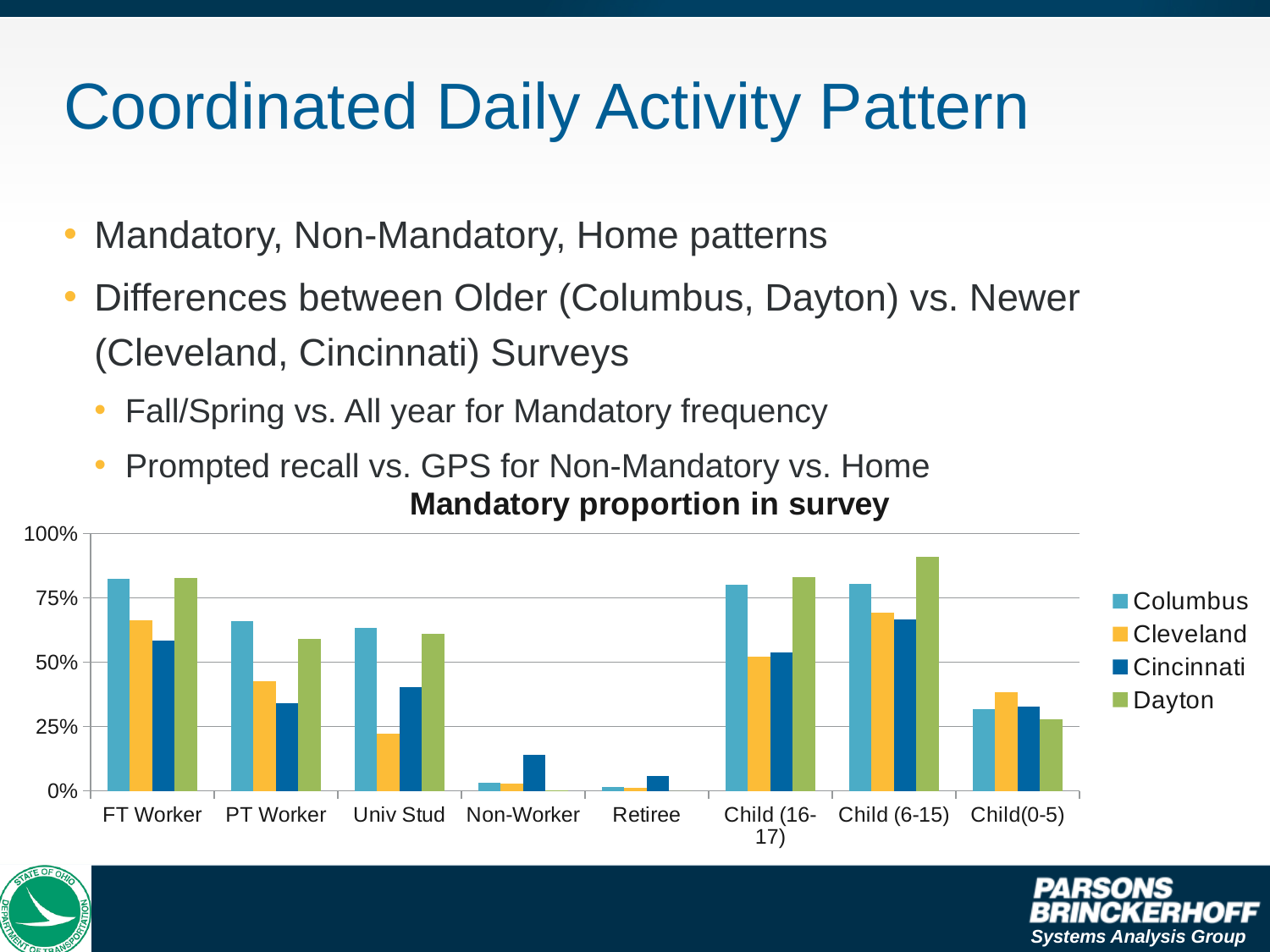
Which series has the lowest value for Univ Stud? Cleveland Is the Dayton value for Child (6-15) greater or less than 75%? greater For PT Worker, which is larger: the Columbus value or the Cincinnati value? Columbus What is the title of the chart? Mandatory proportion in survey For which category is the Dayton value the highest? Child (6-15) Which series has the highest value for Child (6-15)? Dayton For Child(0-5), which is larger: the Cleveland value or the Dayton value? Cleveland Is the Cincinnati value for Non-Worker greater or less than 25%? less What kind of chart is shown on the slide? Bar chart How many series does the legend of the chart list? 4 How many categories are shown along the x axis of the chart? 8